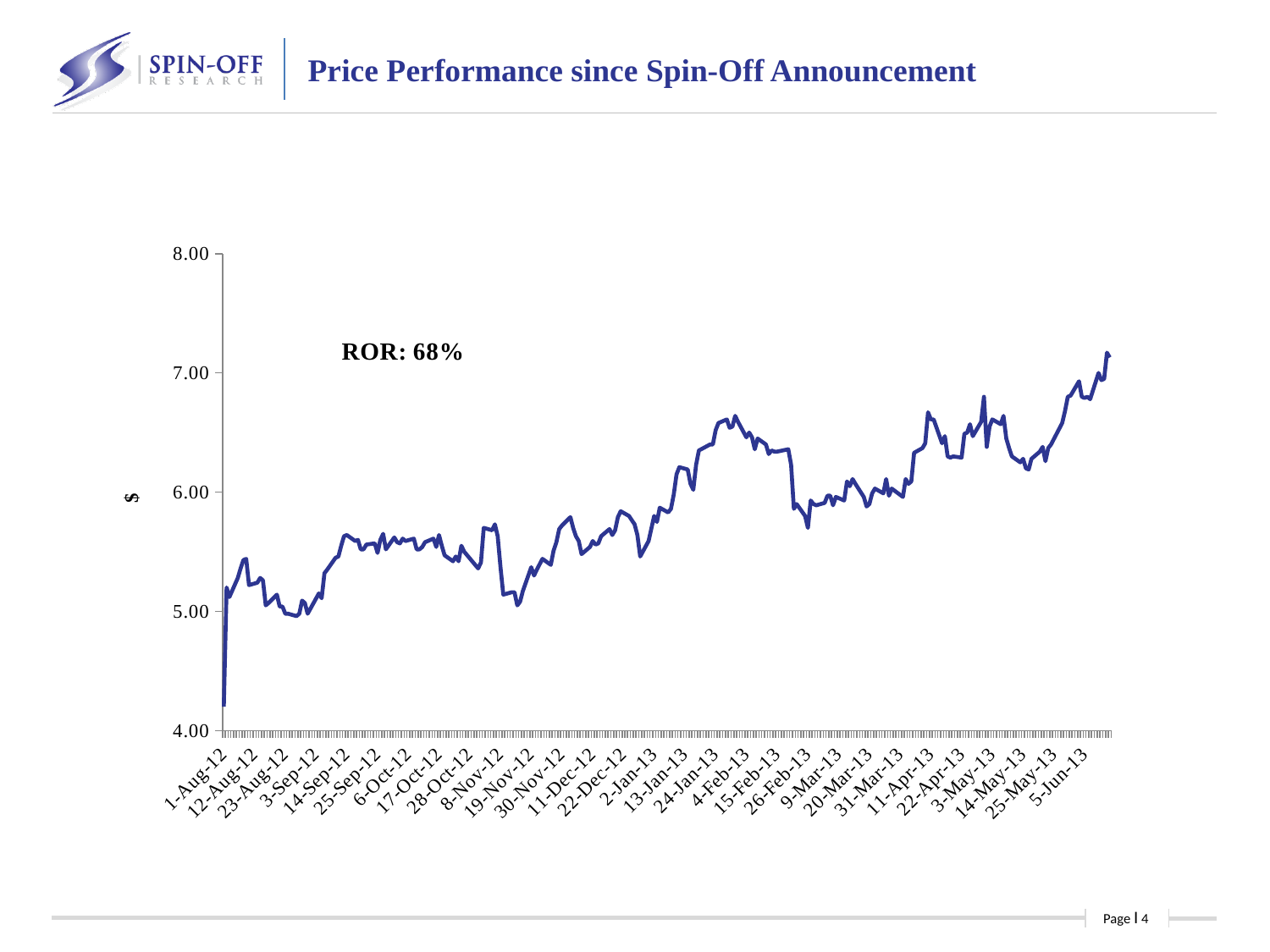
Is the value at 4-Feb-13 greater or less than 6.00? greater Is the value at 1-Aug-12 greater or less than 5.00? less What is the title of the chart on the slide? Price Performance since Spin-Off Announcement Is the value at 14-Sep-12 greater or less than 6.00? less What rate of return (ROR) is annotated on the chart? 68% What kind of chart is shown on the slide? line chart Does the line reach its lowest value near the start or near the end of the period? near the start Overall, does the price rise or fall from 1-Aug-12 to 5-Jun-13? rise Which is larger, the value at 4-Feb-13 or the value at 19-Nov-12? 4-Feb-13